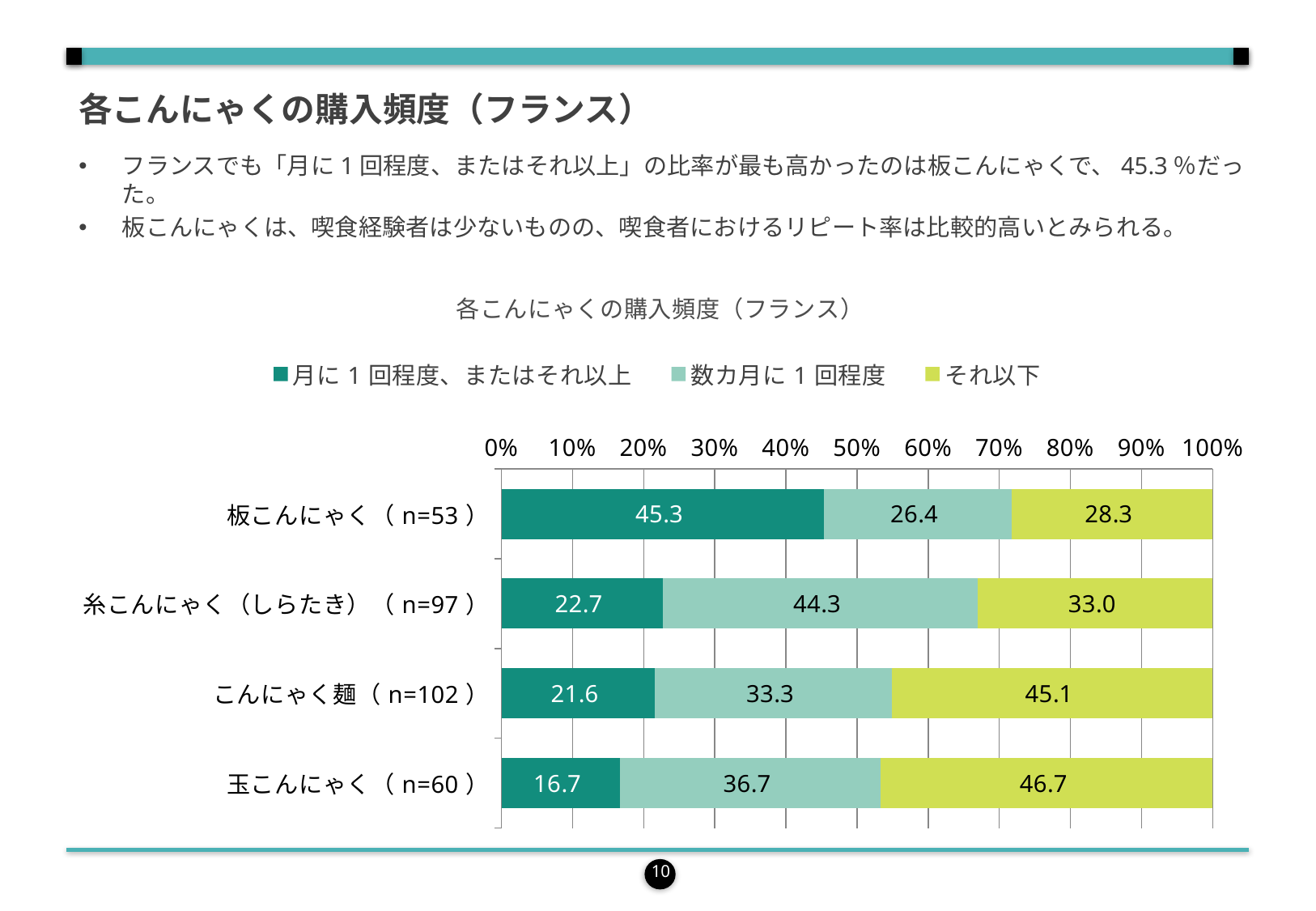
What type of chart is shown on the slide? Stacked bar chart Which is larger: the 数カ月に1回程度 value for 糸こんにゃく（しらたき）（n=97） or for 玉こんにゃく（n=60）? 糸こんにゃく（しらたき）（n=97） What is the value of 数カ月に1回程度 for こんにゃく麺（n=102）? 33.3 What is the difference between the それ以下 values for 玉こんにゃく（n=60） and 板こんにゃく（n=53）? 18.4 Which category has the lowest value for 月に1回程度、またはそれ以上? 玉こんにゃく（n=60） What is the title of the chart? 各こんにゃくの購入頻度（フランス） Which category has the highest value for 月に1回程度、またはそれ以上? 板こんにゃく（n=53） What is the value of 数カ月に1回程度 for 糸こんにゃく（しらたき）（n=97）? 44.3 How many series does the legend list? 3 What is the value of 月に1回程度、またはそれ以上 for 板こんにゃく（n=53）? 45.3 How many categories are shown on the chart? 4 What is the value of それ以下 for 玉こんにゃく（n=60）? 46.7